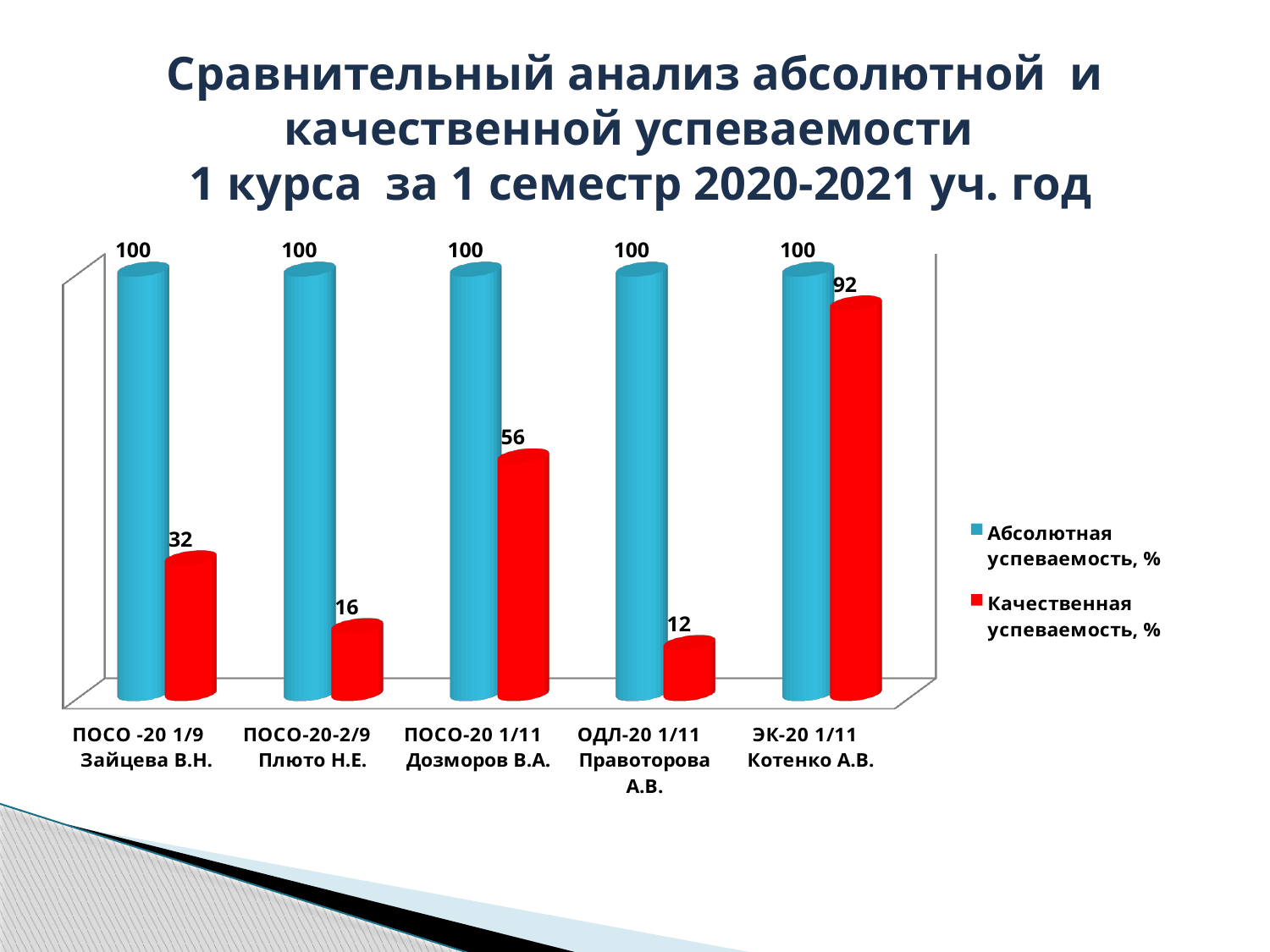
Which has a higher Качественная успеваемость, %: ПОСО -20 1/9 Зайцева В.Н. or ПОСО-20-2/9 Плюто Н.Е.? ПОСО -20 1/9 Зайцева В.Н. What is the difference in Качественная успеваемость, % between ЭК-20 1/11 Котенко А.В. and ПОСО-20-2/9 Плюто Н.Е.? 76 How many series does the legend list? 2 What is the difference between Абсолютная успеваемость, % and Качественная успеваемость, % for ПОСО -20 1/9 Зайцева В.Н.? 68 What kind of chart is shown on the slide? Bar chart What is the value of Абсолютная успеваемость, % for ОДЛ-20 1/11 Правоторова А.В.? 100 What colour are the bars for Качественная успеваемость, %? Red How many groups are shown on the x axis? 5 What is the value of Качественная успеваемость, % for ЭК-20 1/11 Котенко А.В.? 92 Which group has the lowest Качественная успеваемость, %? ОДЛ-20 1/11 Правоторова А.В. What is the value of Качественная успеваемость, % for ПОСО-20 1/11 Дозморов В.А.? 56 Which group has the highest Качественная успеваемость, %? ЭК-20 1/11 Котенко А.В.